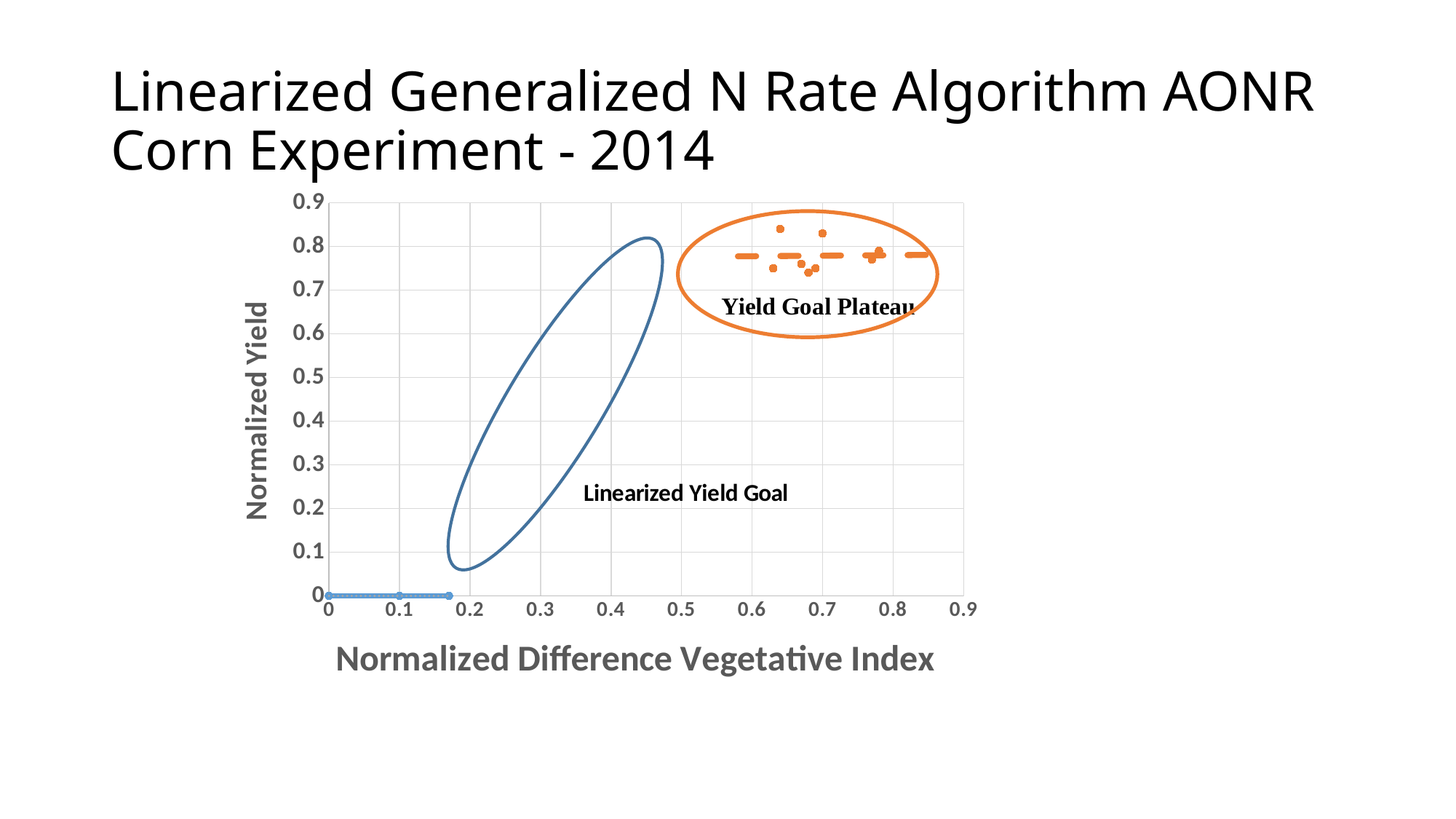
Does the orange dashed line rise, fall, or stay flat as NDVI increases? stay flat What kind of chart is shown on the slide? scatter chart What label is written inside the orange ellipse on the chart? Yield Goal Plateau Is the normalized yield value of the blue point at NDVI 0.1 greater or less than 0.1? less Are the orange points located at NDVI values greater or less than 0.5? greater What is the title of the x axis of the chart? Normalized Difference Vegetative Index Are the normalized yield values of the orange points greater or less than 0.5? greater Which group of points has higher normalized yield values, the blue points or the orange points? the orange points